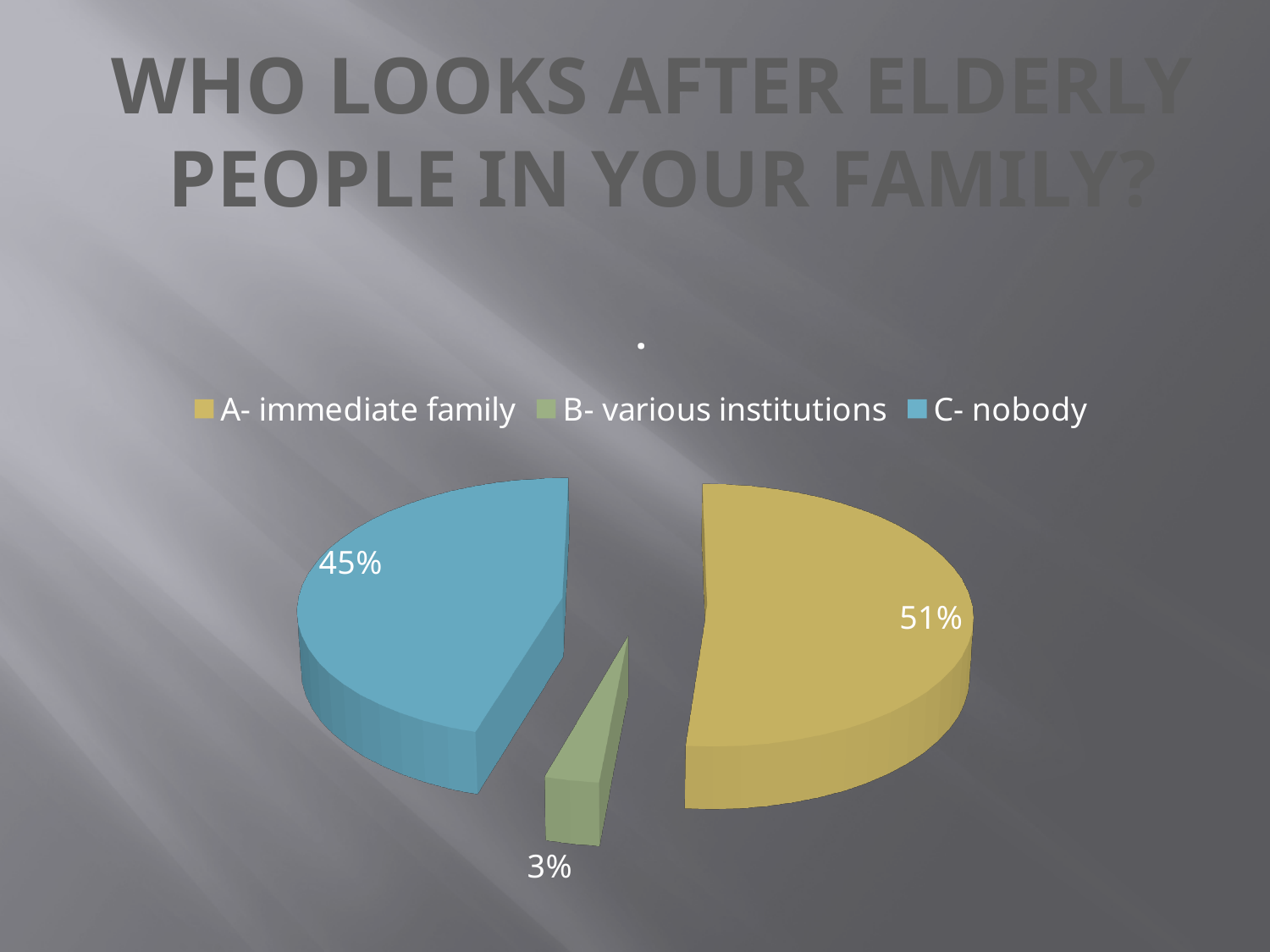
What is the difference between the shares for C- nobody and B- various institutions? 42% What percentage is shown for C- nobody? 45% What is the difference between the shares for A- immediate family and C- nobody? 6% What percentage is shown for B- various institutions? 3% Which category has the largest share of the pie? A- immediate family What kind of chart is shown on the slide? pie chart What percentage is shown for A- immediate family? 51% How many slices does the pie chart have? 3 Which is larger, the share for A- immediate family or the share for C- nobody? A- immediate family How many entries does the legend list? 3 What colour is the slice for C- nobody? blue Which category has the smallest share of the pie? B- various institutions